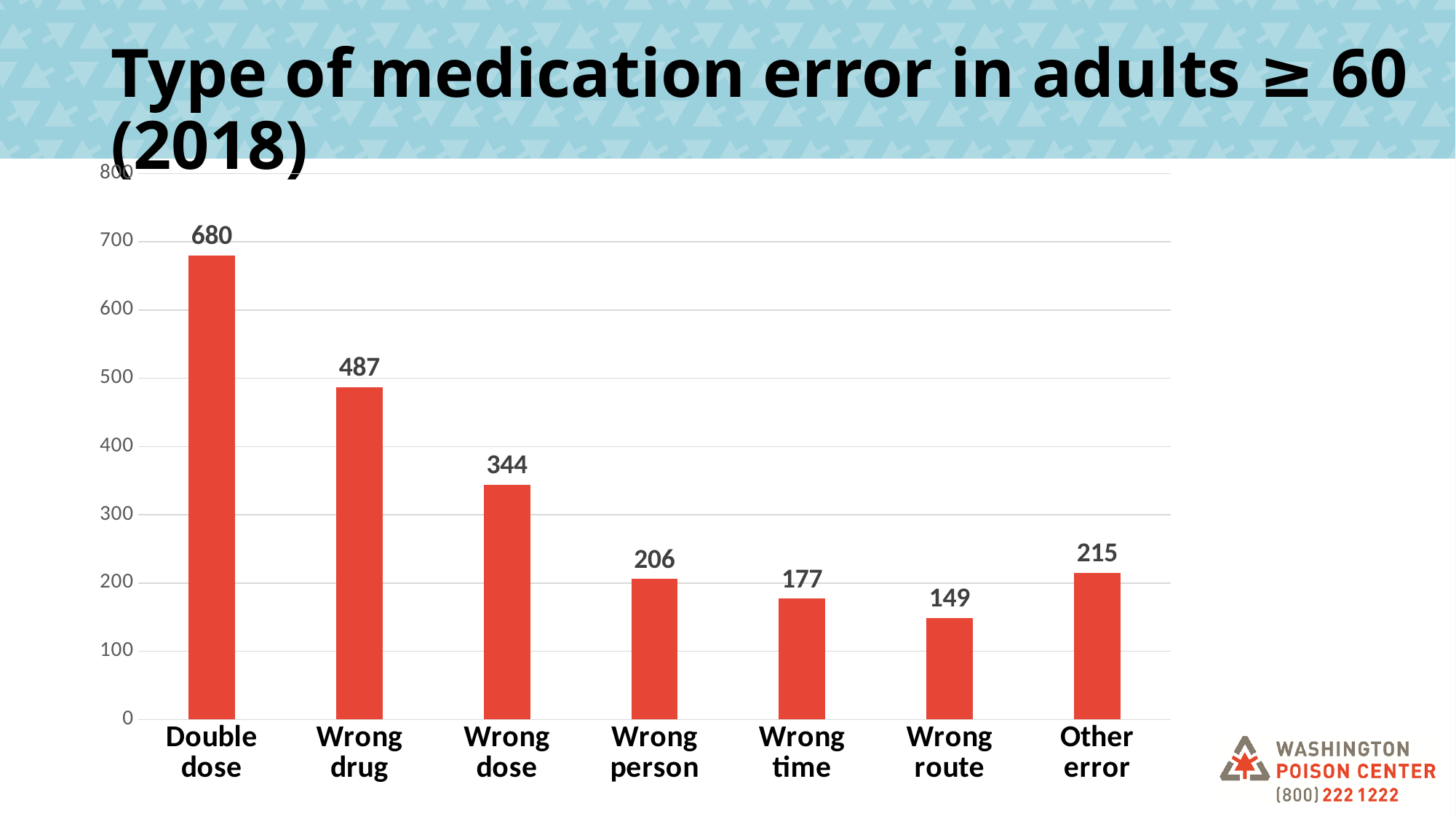
How many categories are shown on the x axis? 7 What kind of chart is shown on the slide? Bar chart Which is larger, the value for Other error or the value for Wrong person? Other error What is the value for Double dose? 680 What is the title of the chart on the slide? Type of medication error in adults ≥ 60 (2018) What is the difference between the values for Wrong person and Wrong time? 29 Which type of medication error has the lowest value? Wrong route What is the value for Other error? 215 Is the value for Wrong dose greater or less than 300? greater What is the difference between the values for Double dose and Wrong drug? 193 What is the value for Wrong route? 149 Which type of medication error has the highest value? Double dose